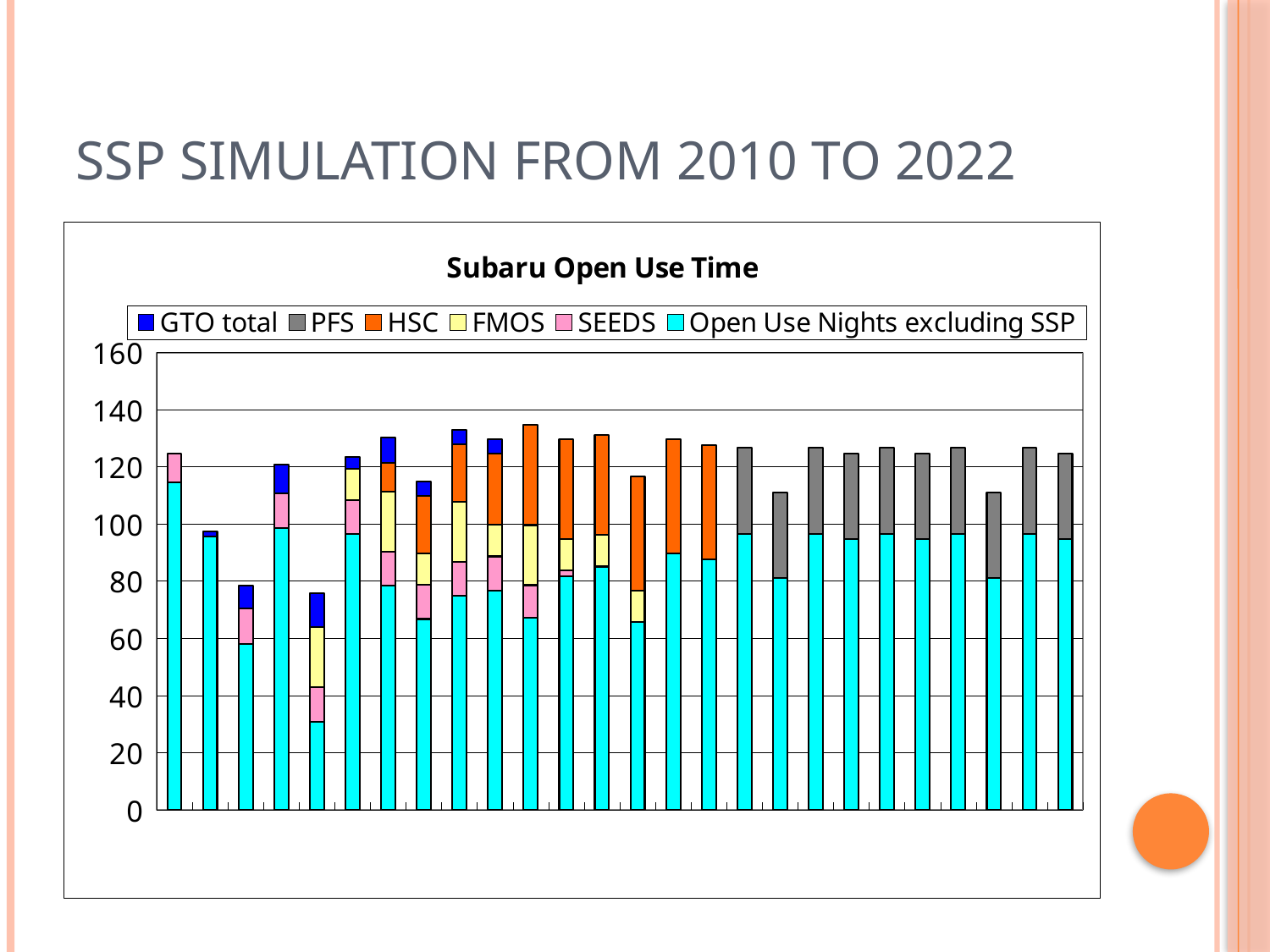
Is the total of the second bar from the left greater or less than 80? greater Is the total of the fifth bar from the left greater or less than 100? less Is the total of the eleventh bar from the left greater or less than 120? greater What is the title of the chart? Subaru Open Use Time How many series does the legend list? 6 Which series is shown in cyan at the bottom of each stacked bar? Open Use Nights excluding SSP What kind of chart is shown on the slide? Stacked bar chart How many stacked bars are plotted in the chart? 26 Which is taller, the first bar from the left or the fifth bar from the left? The first bar from the left